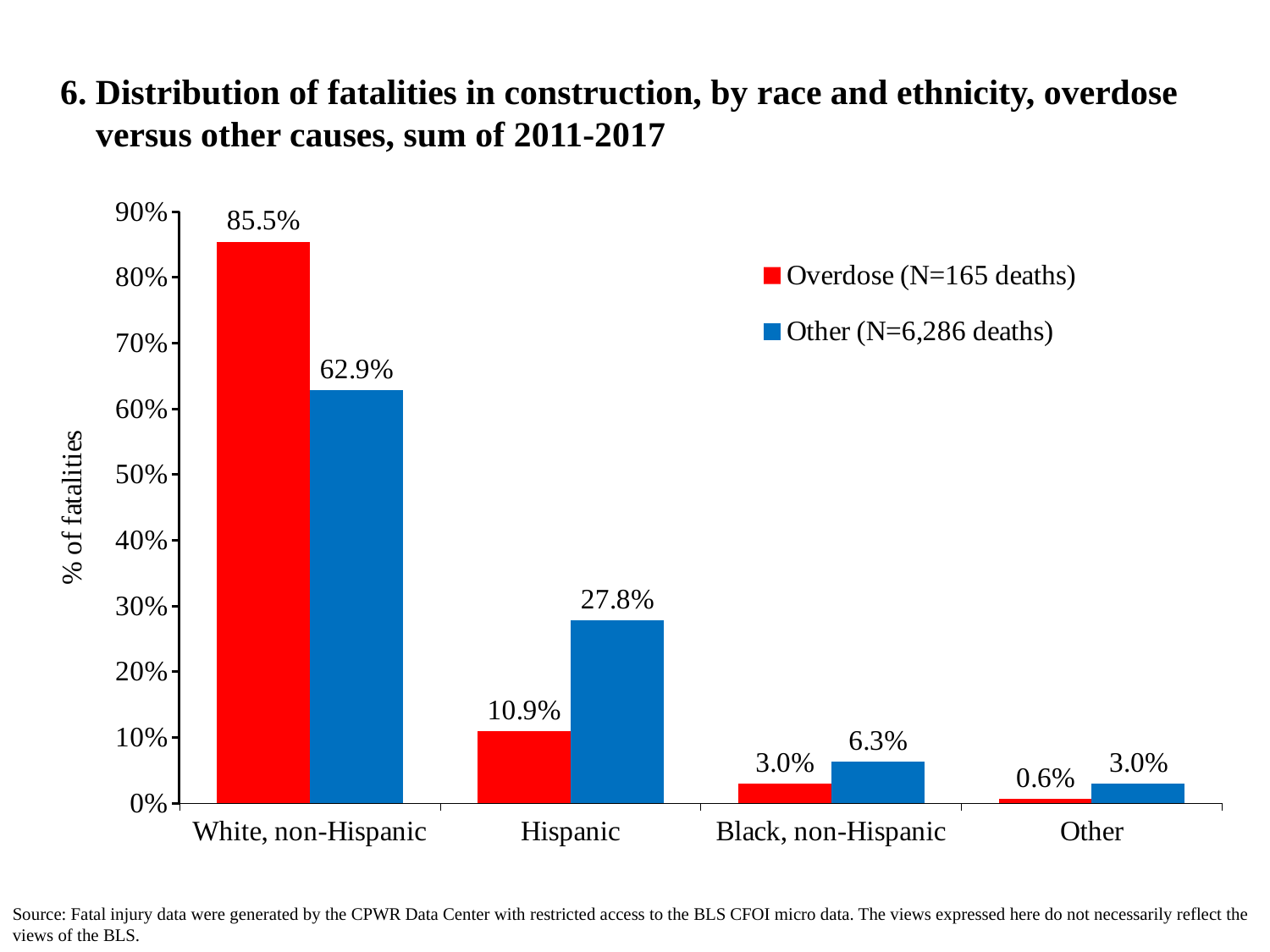
What is the Overdose value for Black, non-Hispanic? 3.0% What is the difference between the Overdose and Other values for White, non-Hispanic? 22.6% What is the Overdose value for the Other race/ethnicity category? 0.6% What kind of chart is shown on the slide? Bar chart How many series does the legend list? 2 Which race/ethnicity category has the lowest Other value? Other For Hispanic, which is larger: the Overdose value or the Other value? Other What is the Other value for Hispanic? 27.8% What is the Overdose value for White, non-Hispanic? 85.5% How many race/ethnicity categories are shown on the x axis? 4 What is the difference between the Other and Overdose values for Hispanic? 16.9% Which race/ethnicity category has the highest Overdose value? White, non-Hispanic